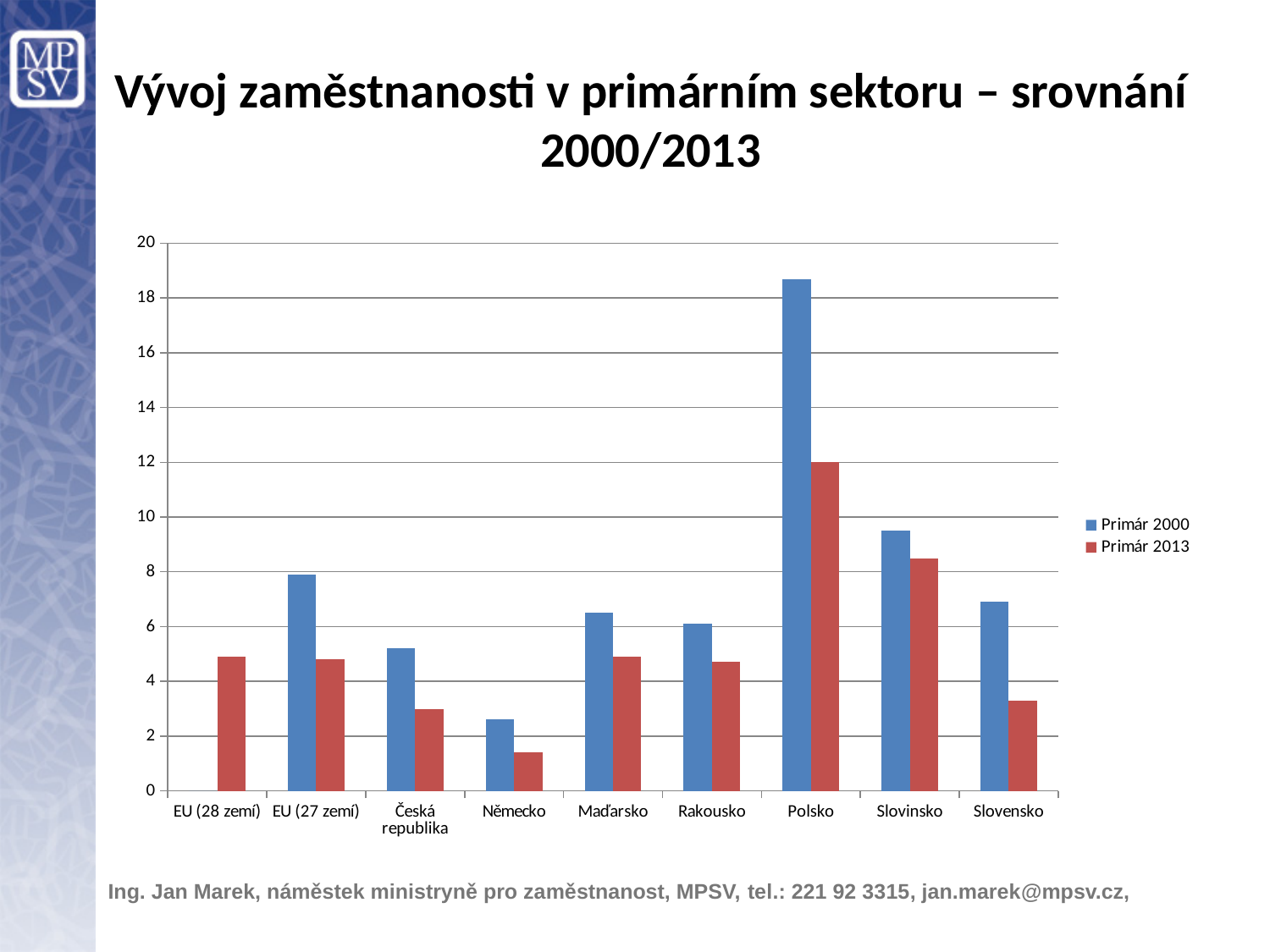
How many categories are shown on the x axis? 9 Is the Primár 2000 value for Polsko greater or less than 18? greater Is the Primár 2000 value for Slovinsko greater or less than 8? greater Is the Primár 2013 value for Slovensko greater or less than 4? less Which category has the highest value for Primár 2000? Polsko How many series does the legend list? 2 Which is larger for Slovensko: the Primár 2000 value or the Primár 2013 value? Primár 2000 Which is larger: the Primár 2000 value for Maďarsko or the Primár 2000 value for Německo? Maďarsko What are the two series names listed in the legend? Primár 2000 and Primár 2013 Which category has the lowest value for Primár 2013? Německo What kind of chart is shown on the slide? bar chart Which category has the highest value for Primár 2013? Polsko